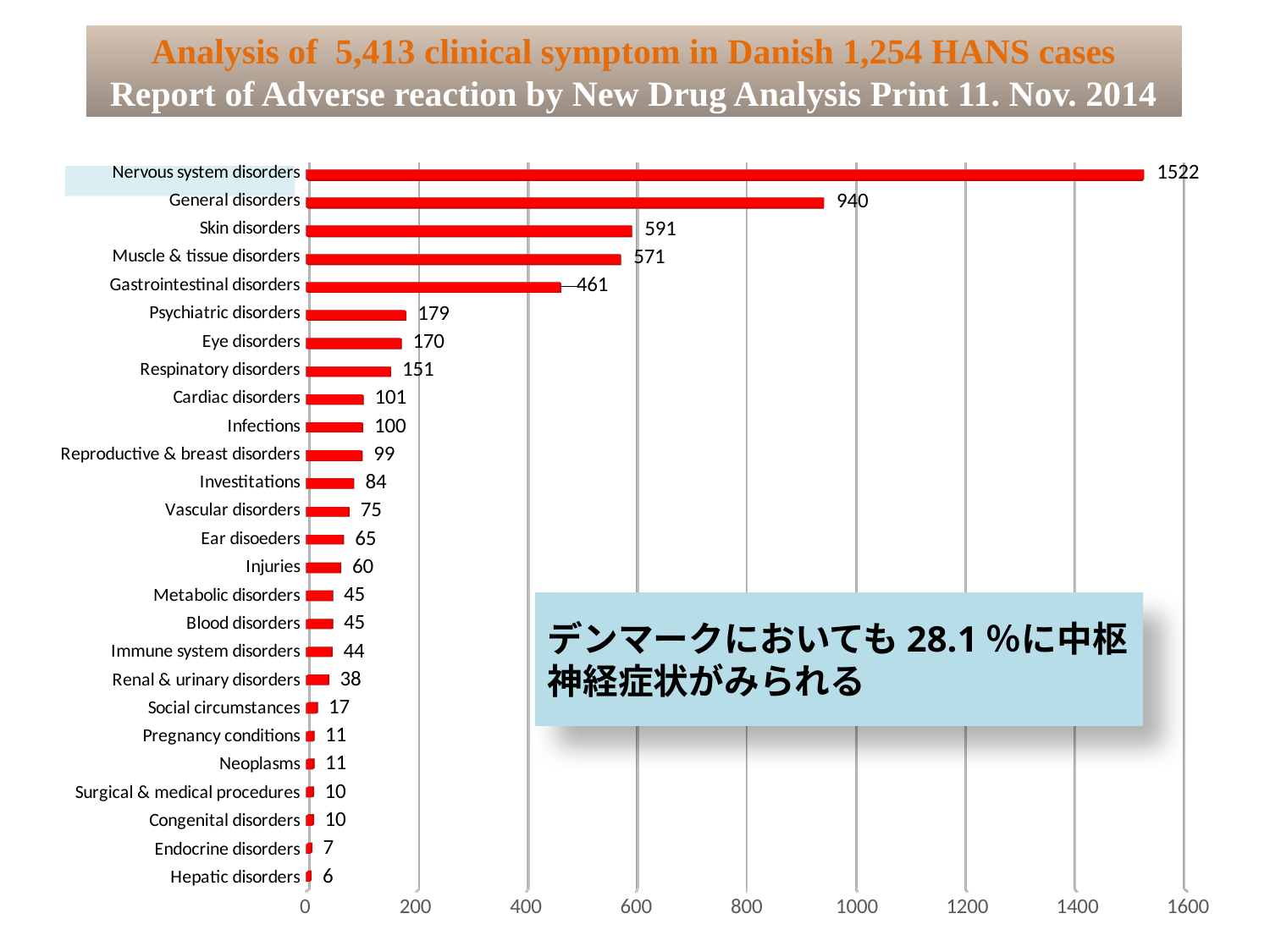
What is the difference between the values for Skin disorders and Muscle & tissue disorders? 20 Which is larger, the value for Psychiatric disorders or the value for Eye disorders? Psychiatric disorders What kind of chart is shown on the slide? bar chart Is the value for General disorders greater or less than 800? greater What is the value for Gastrointestinal disorders? 461 What is the difference between the values for Nervous system disorders and General disorders? 582 What is the value for Renal & urinary disorders? 38 Which category has the highest value? Nervous system disorders What is the value for Respiratory disorders? 151 Which category has the lowest value? Hepatic disorders How many categories are shown in the chart? 26 What is the value for Nervous system disorders? 1522